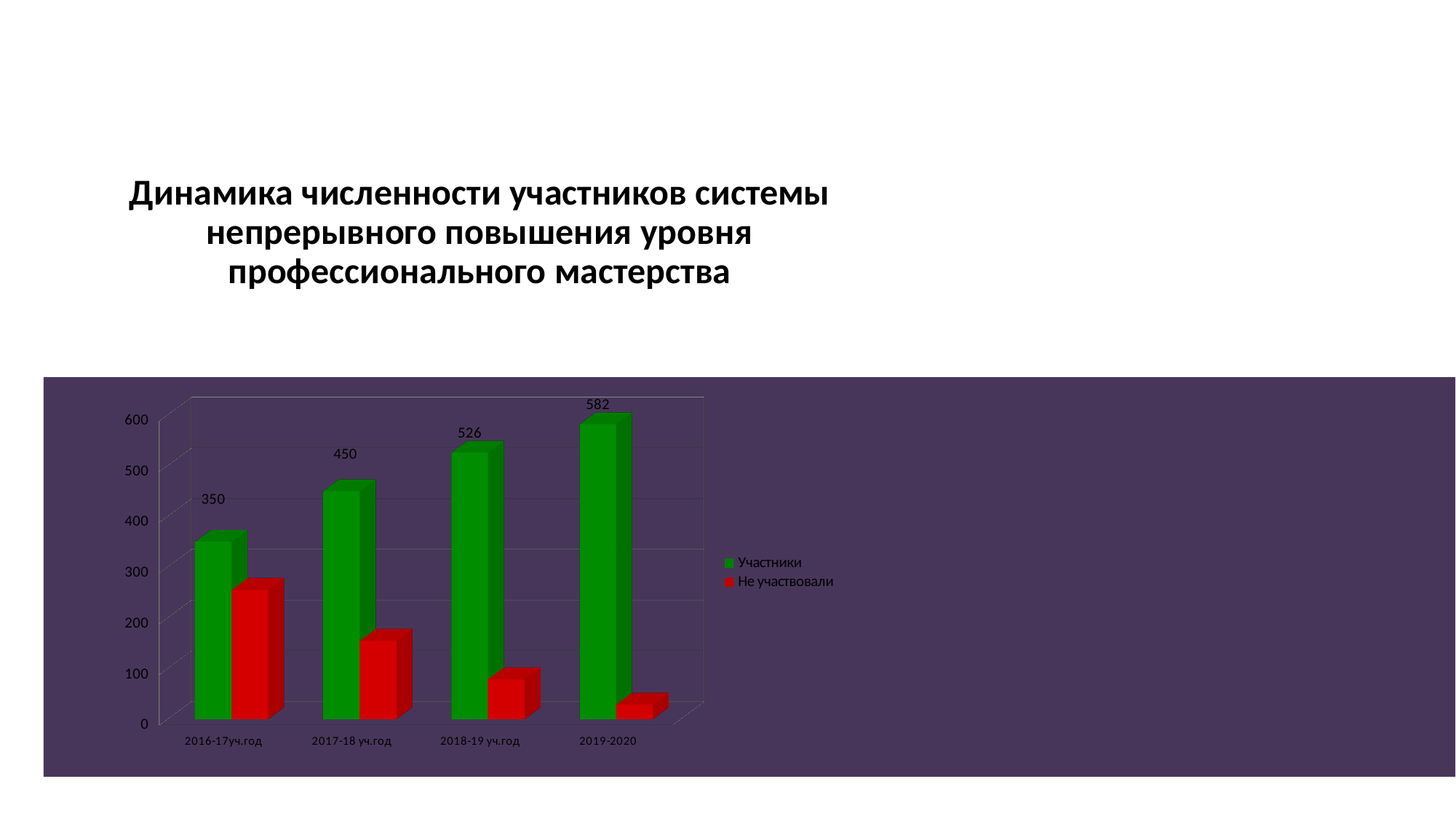
What is the value for Участники in 2016-17уч.год? 350 Do the Участники values rise or fall from 2016-17уч.год to 2019-2020? rise In which year is the Участники value highest? 2019-2020 Which is larger: the Участники value for 2017-18 уч.год or for 2018-19 уч.год? 2018-19 уч.год What is the value for Участники in 2017-18 уч.год? 450 Is the value for Не участвовали in 2019-2020 greater or less than 100? less How many series does the legend list? 2 What is the difference between the Участники values for 2019-2020 and 2016-17уч.год? 232 What is the value for Участники in 2018-19 уч.год? 526 What is the value for Участники in 2019-2020? 582 Is the value for Не участвовали in 2016-17уч.год greater or less than 100? greater In which year is the Участники value lowest? 2016-17уч.год